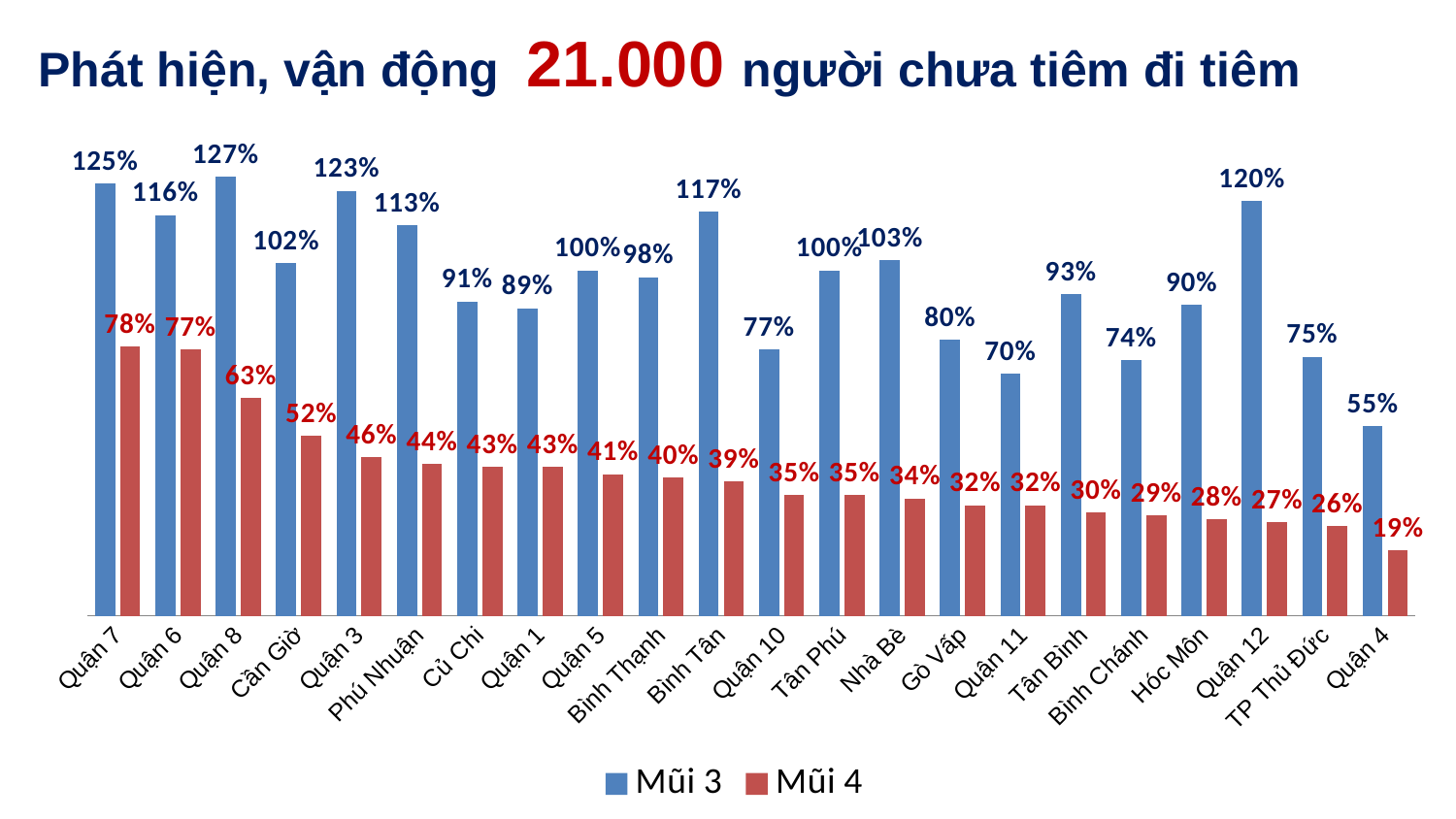
Which is larger, the Mũi 3 value for Bình Tân or the Mũi 3 value for Quận 6? Bình Tân What is the Mũi 4 value for Cần Giờ? 52% Do the Mũi 4 values generally rise or fall from left to right along the x axis? Fall What is the Mũi 3 value for Quận 8? 127% What is the difference between the Mũi 3 and Mũi 4 values for Quận 12? 93% What kind of chart is shown on the slide? Bar chart Which category has the highest Mũi 4 value? Quận 7 What is the Mũi 3 value for Hóc Môn? 90% How many series does the legend list? 2 What colour are the Mũi 4 bars? Red Which category has the lowest Mũi 3 value? Quận 4 How many categories are shown on the x axis? 22